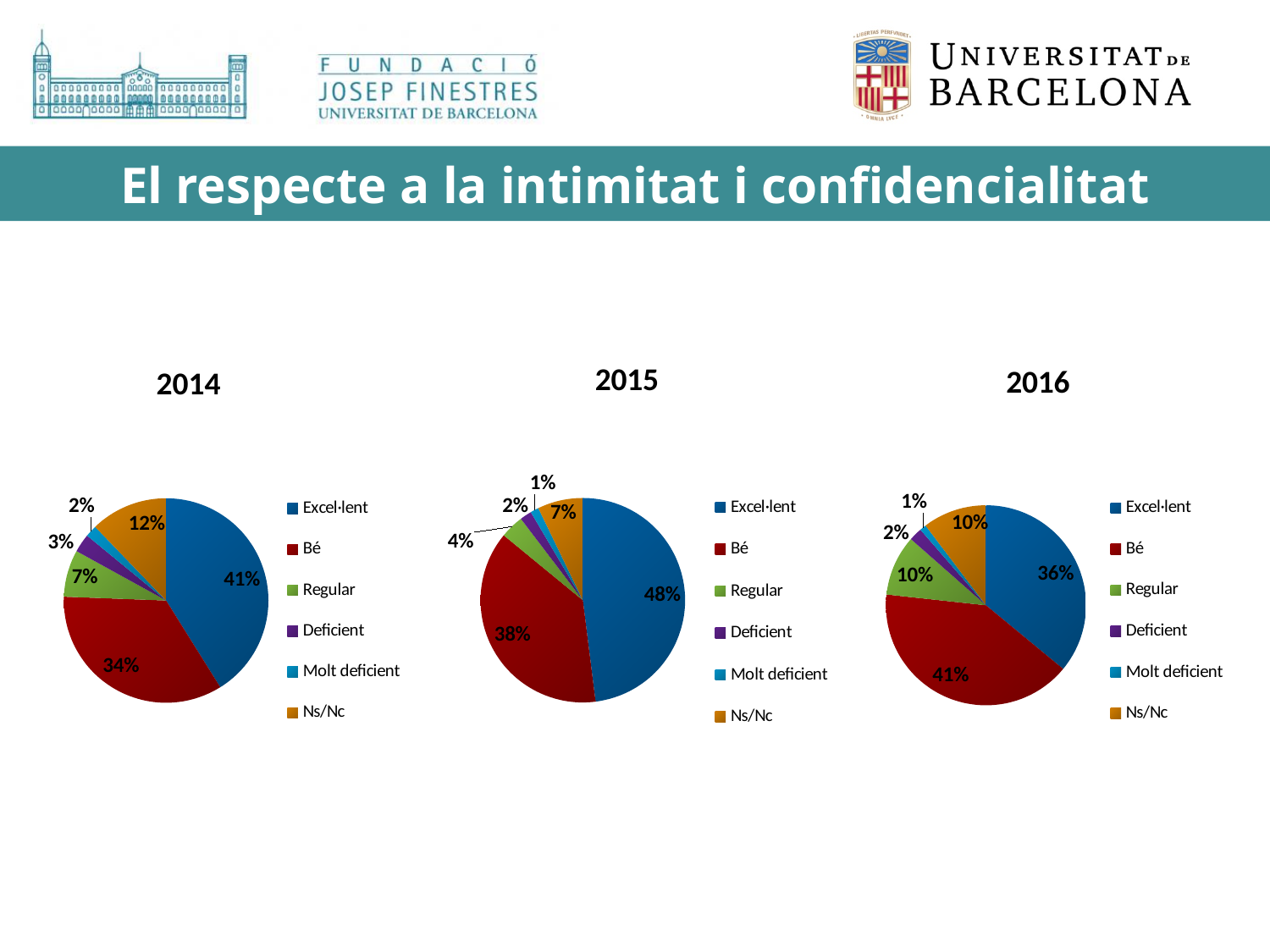
In the 2016 pie chart, which category has the largest slice? Bé How many categories does the legend of the 2015 pie chart list? 6 In the 2015 pie chart, which category has the largest slice? Excel·lent In the 2016 pie chart, what share is labelled for Regular? 10% In the 2015 pie chart, what share is labelled for Bé? 38% In the 2016 pie chart, which is larger, Excel·lent or Bé? Bé How many pie charts are shown on the slide? 3 In the 2015 pie chart, which category has the smallest slice? Molt deficient In the 2014 pie chart, what is the difference between the Excel·lent and Bé shares? 7% What type of chart is used for the 2014 data? Pie chart In the 2014 pie chart, what share is labelled for Excel·lent? 41% In the 2014 pie chart, what share is labelled for Ns/Nc? 12%